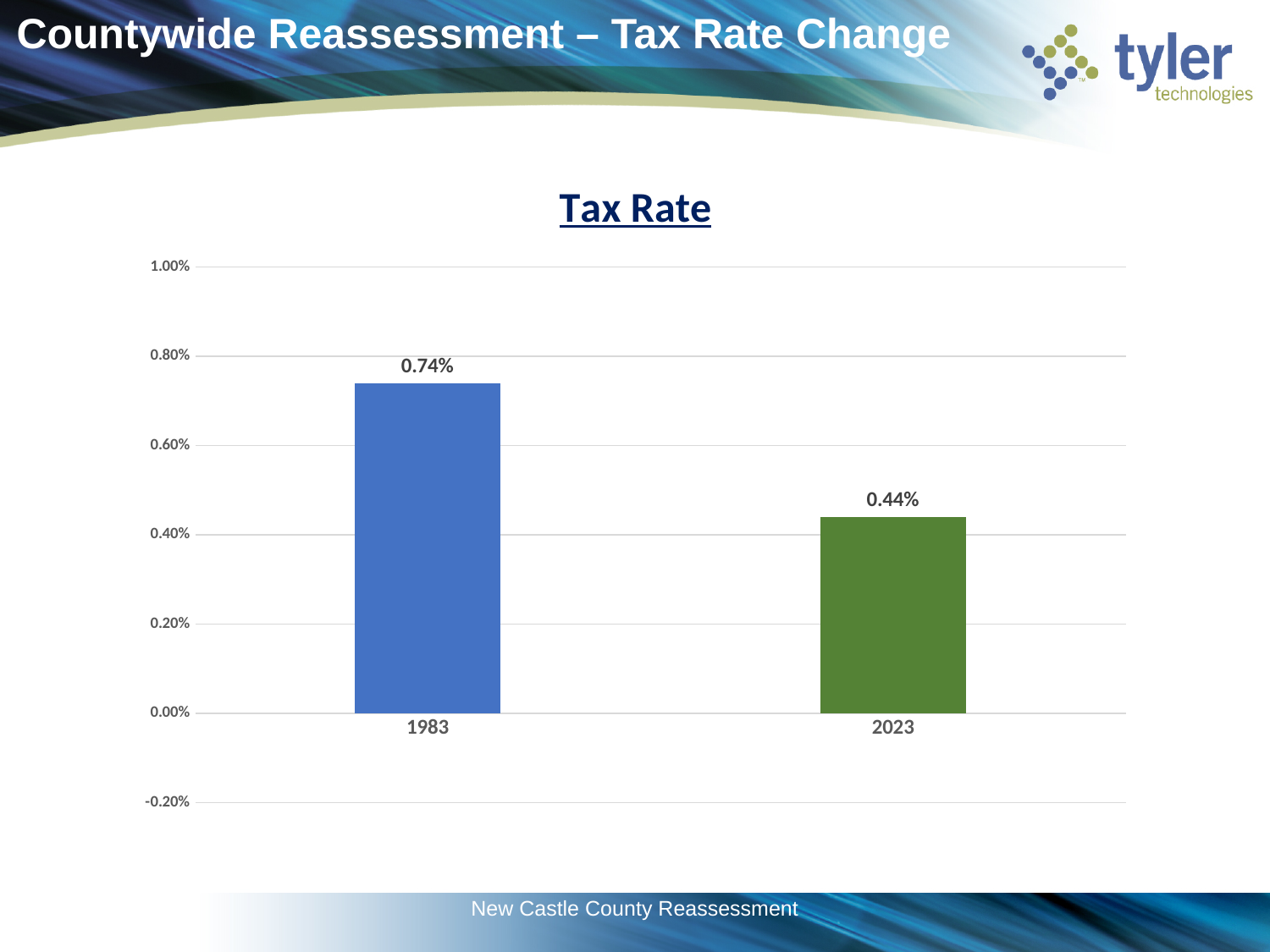
Is the value for 1983 greater or less than 0.60%? greater What is the title of the chart? Tax Rate Does the tax rate rise or fall from 1983 to 2023? fall What is the tax rate shown for 2023? 0.44% Which year has the lower tax rate? 2023 Is the tax rate for 1983 larger or smaller than the tax rate for 2023? larger What is the difference between the 1983 and 2023 tax rates? 0.30% What kind of chart is shown on the slide? bar chart Is the value for 2023 greater or less than 0.60%? less How many years are plotted in the chart? 2 What is the tax rate shown for 1983? 0.74% Which year has the higher tax rate? 1983